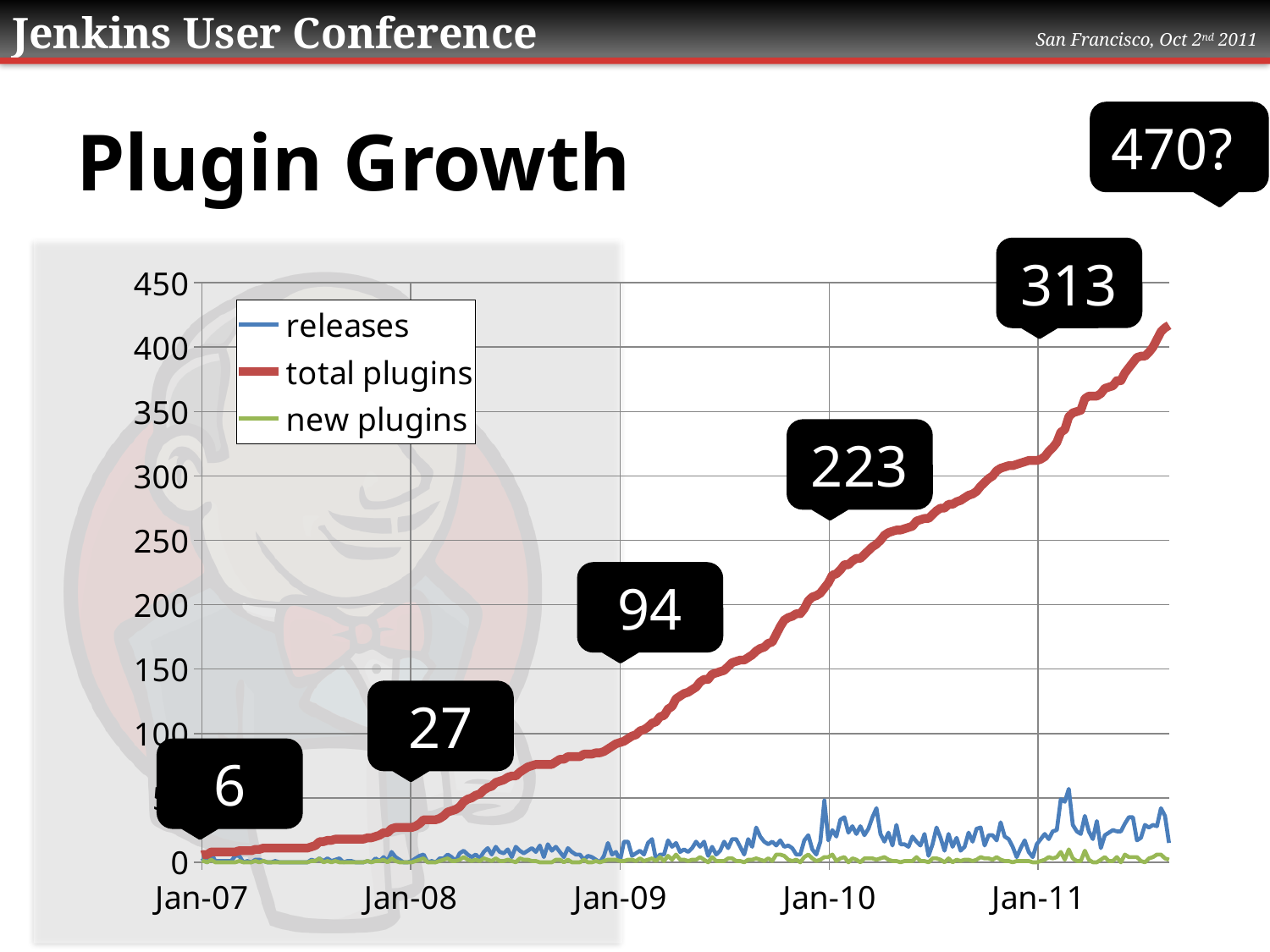
By how much did the labelled total plugins value increase from Jan-09 to Jan-10? 129 What kind of chart is shown on the slide? line chart What is the title of the chart on the slide? Plugin Growth What is the total plugins value labelled at Jan-08? 27 How many series does the legend list? 3 What is the total plugins value labelled at Jan-10? 223 Does the total plugins line rise or fall from Jan-07 to the end of the chart? rises Which series reaches the highest value on the chart? total plugins By how much did the labelled total plugins value increase from Jan-10 to Jan-11? 90 What is the total plugins value labelled at Jan-11? 313 What is the total plugins value labelled at Jan-09? 94 What is the total plugins value labelled at Jan-07? 6